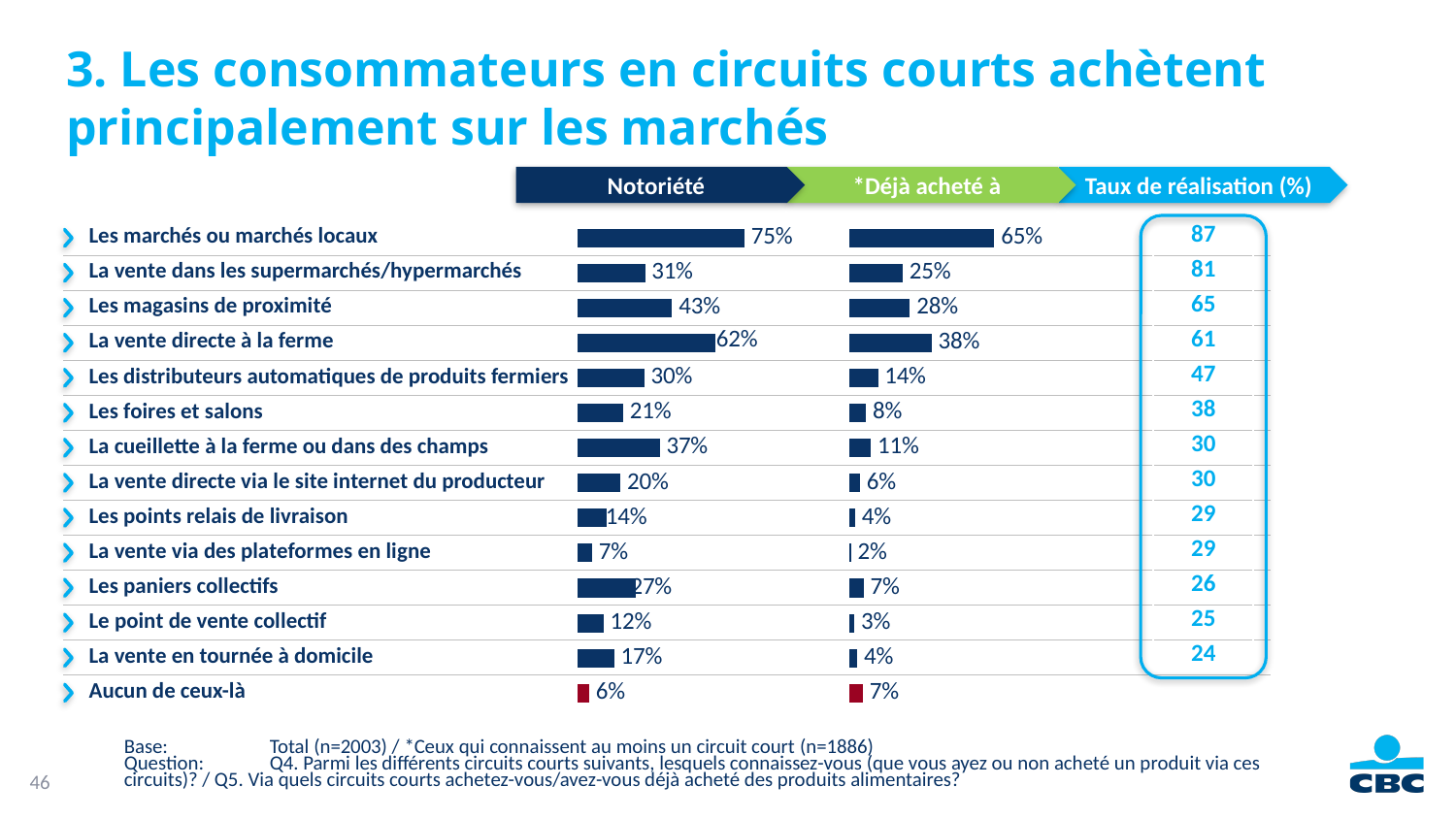
In the Déjà acheté à chart, what is the difference between Les marchés ou marchés locaux and Les magasins de proximité? 37% What is the Taux de réalisation (%) for La vente dans les supermarchés/hypermarchés? 81 In the Notoriété chart, what is the value for Les paniers collectifs? 27% In the Notoriété chart, what is the difference between Les marchés ou marchés locaux and La vente directe à la ferme? 13% In the Notoriété chart, what is the value for Les marchés ou marchés locaux? 75% In the Déjà acheté à chart, which category has the highest value? Les marchés ou marchés locaux How many categories are listed in the Notoriété chart? 14 In the Déjà acheté à chart, which category has the lowest value? La vente via des plateformes en ligne In the Déjà acheté à chart, which is larger: Les foires et salons or Les distributeurs automatiques de produits fermiers? Les distributeurs automatiques de produits fermiers What kind of chart is used for the Notoriété and Déjà acheté à data? Bar chart In the Notoriété chart, which is larger: Les magasins de proximité or La cueillette à la ferme ou dans des champs? Les magasins de proximité In the Déjà acheté à chart, what is the value for La vente directe à la ferme? 38%